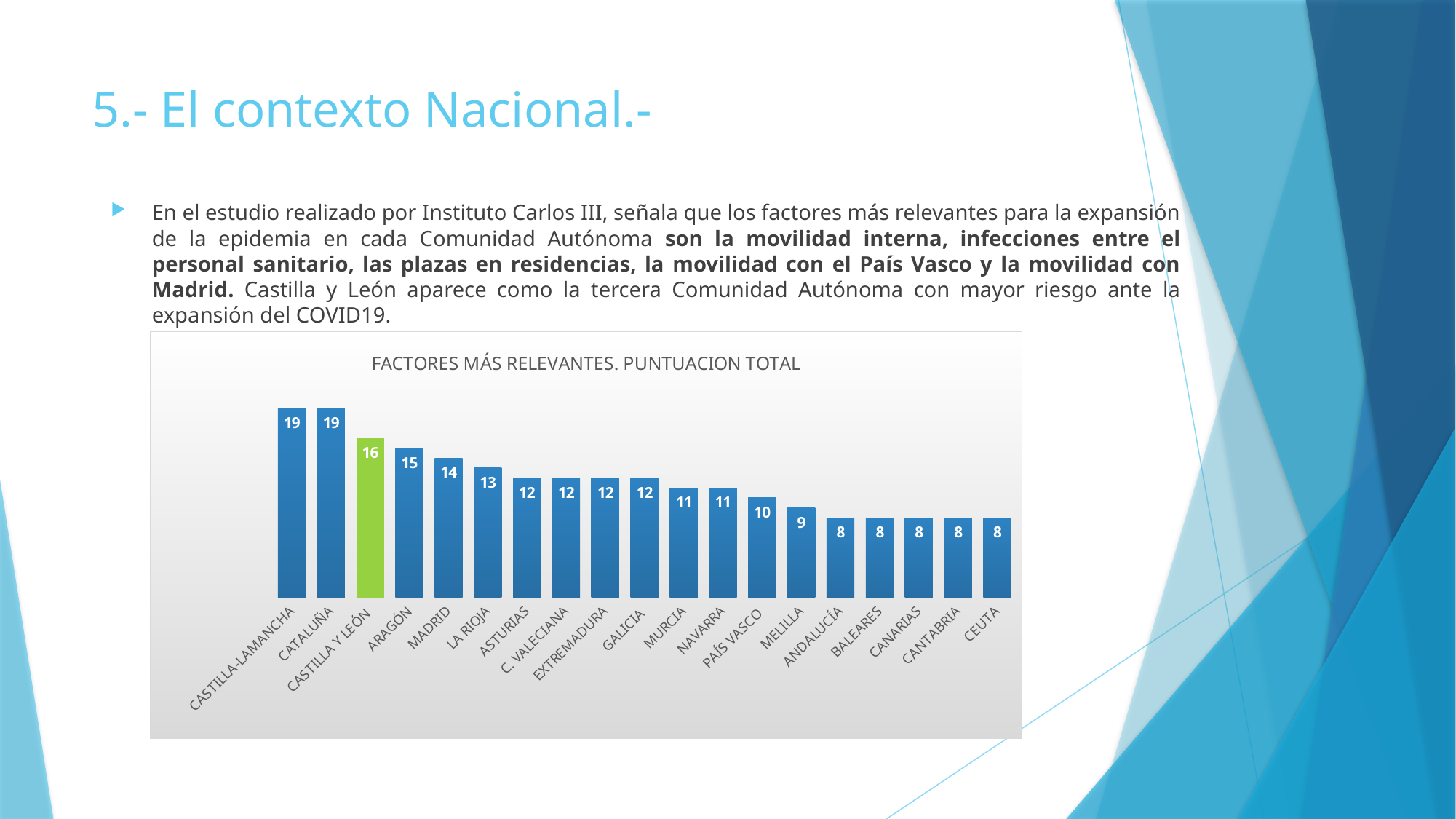
What is the value for CASTILLA Y LEÓN? 16 What is the value for CATALUÑA? 19 What kind of chart is shown on the slide? Bar chart What is the value for MADRID? 14 Which has a larger value, ARAGÓN or LA RIOJA? ARAGÓN What is the value for PAÍS VASCO? 10 What is the highest value shown in the chart? 19 What is the value for MELILLA? 9 What is the difference between the values for CASTILLA-LAMANCHA and CASTILLA Y LEÓN? 3 How many categories are shown in the chart? 19 Which category's bar is coloured green instead of blue? CASTILLA Y LEÓN What is the lowest value shown in the chart? 8